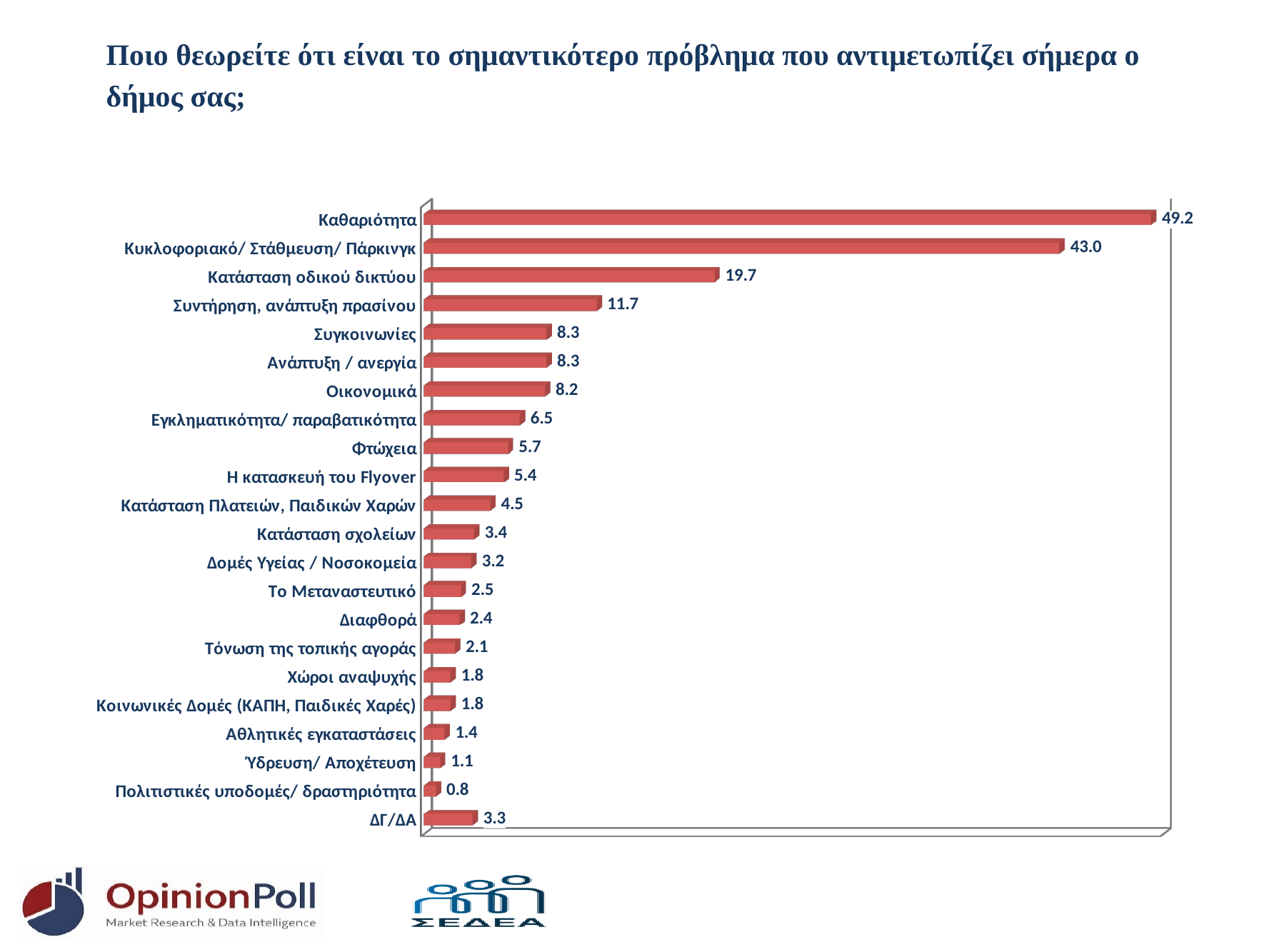
What value is shown for Κατάσταση οδικού δικτύου? 19.7 Which is larger, the value for Φτώχεια or the value for Εγκληματικότητα/ παραβατικότητα? Εγκληματικότητα/ παραβατικότητα What colour are the bars in the chart? Red What kind of chart is shown on the slide? Bar chart What value is shown for Η κατασκευή του Flyover? 5.4 Which category has the lowest value? Πολιτιστικές υποδομές/ δραστηριότητα What is the difference between the values for Καθαριότητα and Κυκλοφοριακό/ Στάθμευση/ Πάρκινγκ? 6.2 What value is shown for ΔΓ/ΔΑ? 3.3 What value is shown for Καθαριότητα? 49.2 How many categories are shown in the chart? 22 Which category has the highest value? Καθαριότητα What is the difference between the values for Κατάσταση οδικού δικτύου and Συντήρηση, ανάπτυξη πρασίνου? 8.0